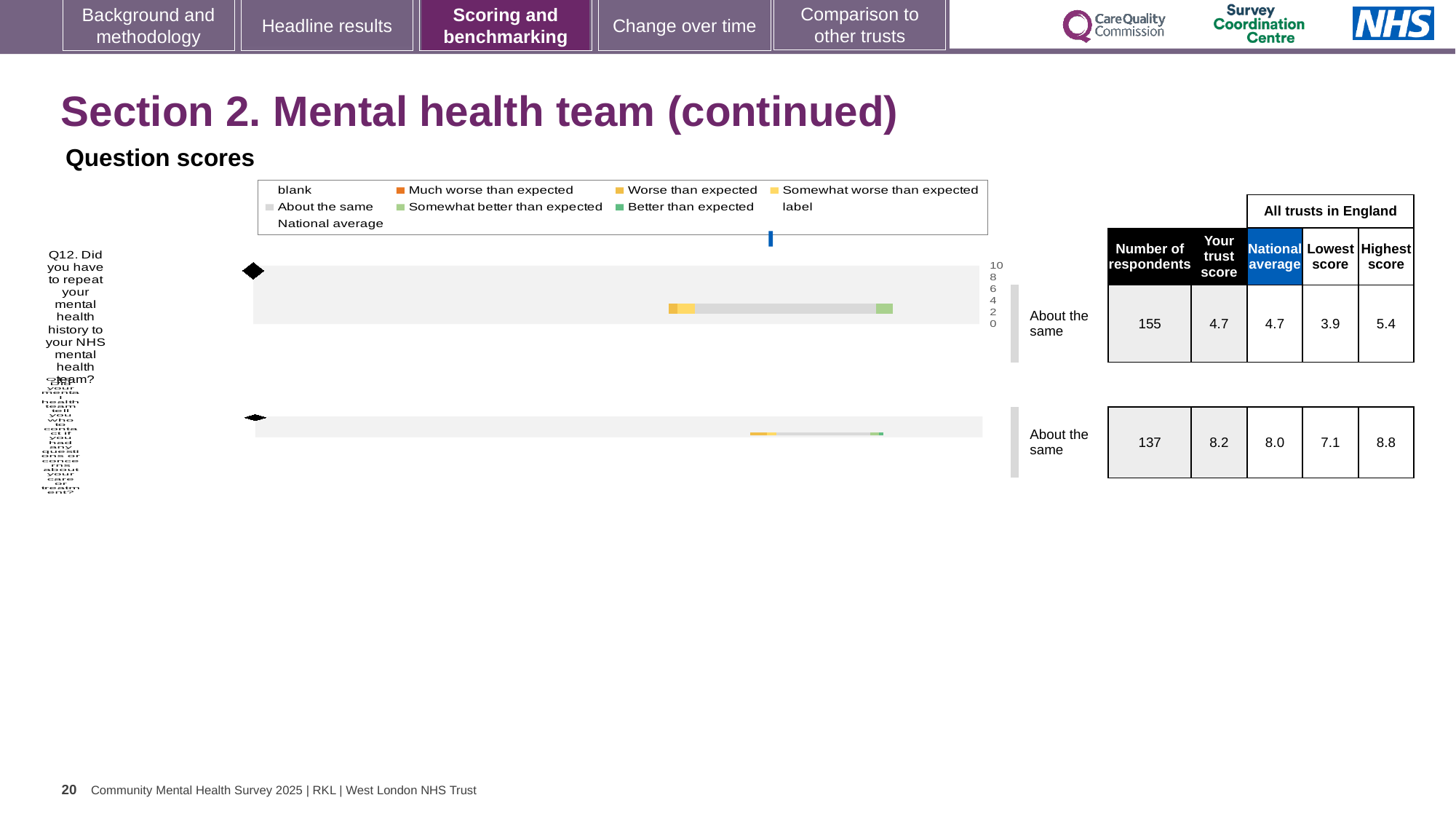
In the legend, what colour represents 'Better than expected'? green For the second (lower) question, what is the difference between 'Your trust score' and the 'National average'? 0.2 What benchmark category is shown next to the second (lower) question score chart? About the same What kind of chart is used to show the question scores on this slide? bar chart What benchmark category is shown next to the chart for Q12 (repeating mental health history)? About the same In the table beside the Q12 chart, what is 'Your trust score'? 4.7 In the legend, what colour represents 'Much worse than expected'? orange In the table beside the Q12 chart, what is the lowest score among all trusts in England? 3.9 How many entries does the legend above the question score charts list? 9 For the second (lower) question, which is larger: 'Your trust score' or the 'National average'? Your trust score In the table beside the Q12 chart, how many respondents are listed? 155 In the table beside the second (lower) question chart, what is the highest score among all trusts in England? 8.8